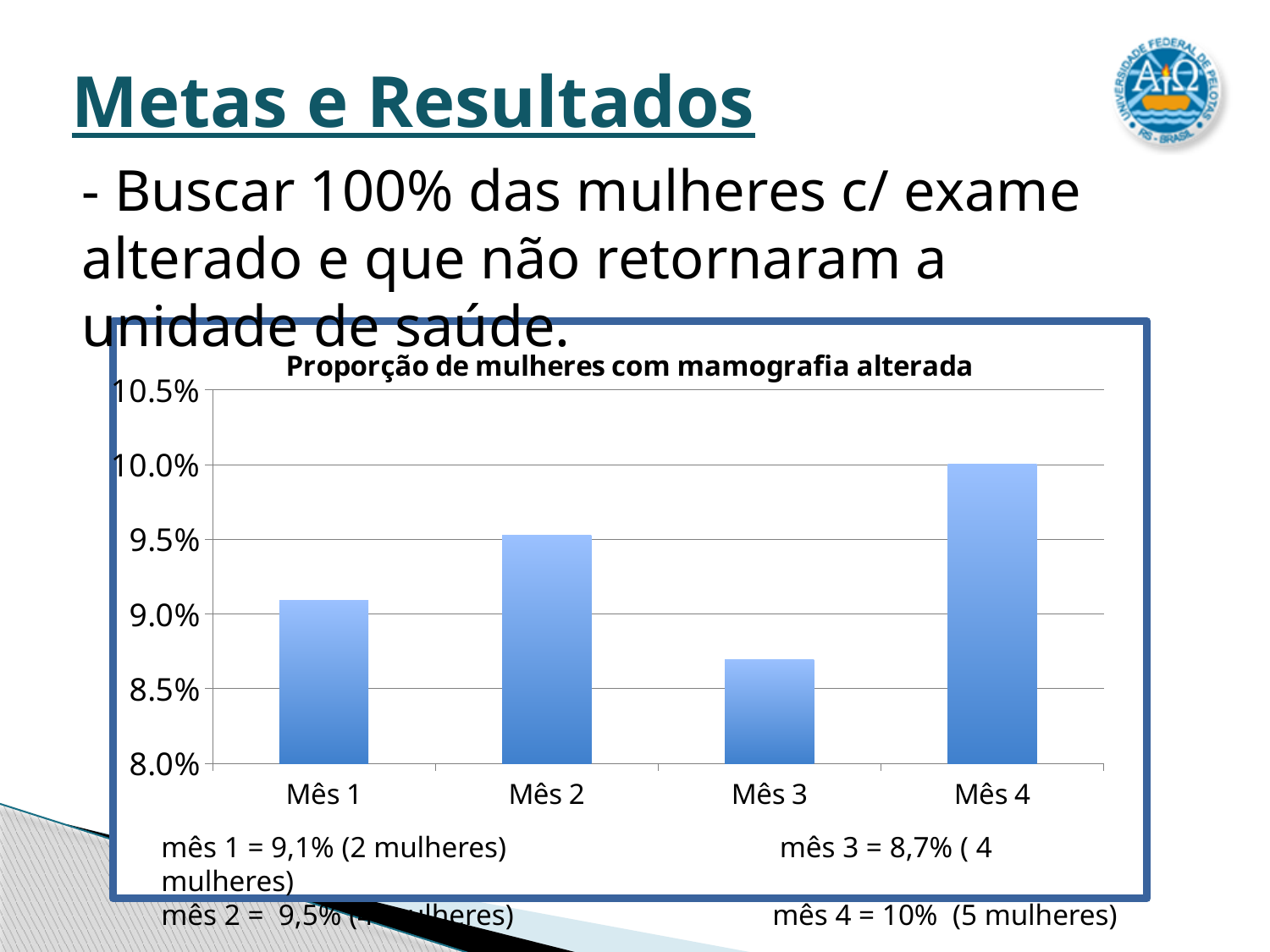
Which month has the lowest proportion of women with altered mammography? Mês 3 Is the value for Mês 3 greater or less than 8.5%? greater Which is larger, the value for Mês 2 or the value for Mês 1? Mês 2 Is the value for Mês 1 greater or less than 9.0%? greater Which month has the highest proportion of women with altered mammography? Mês 4 What is the title of the chart? Proporção de mulheres com mamografia alterada How many months (categories) are plotted in the chart? 4 According to the note below the chart, how many women does the Mês 4 value correspond to? 5 mulheres What is the value for Mês 4 in the chart? 10.0% Does the value rise or fall from Mês 3 to Mês 4? rise What kind of chart is shown on the slide? bar chart Is the value for Mês 3 greater or less than 9.0%? less